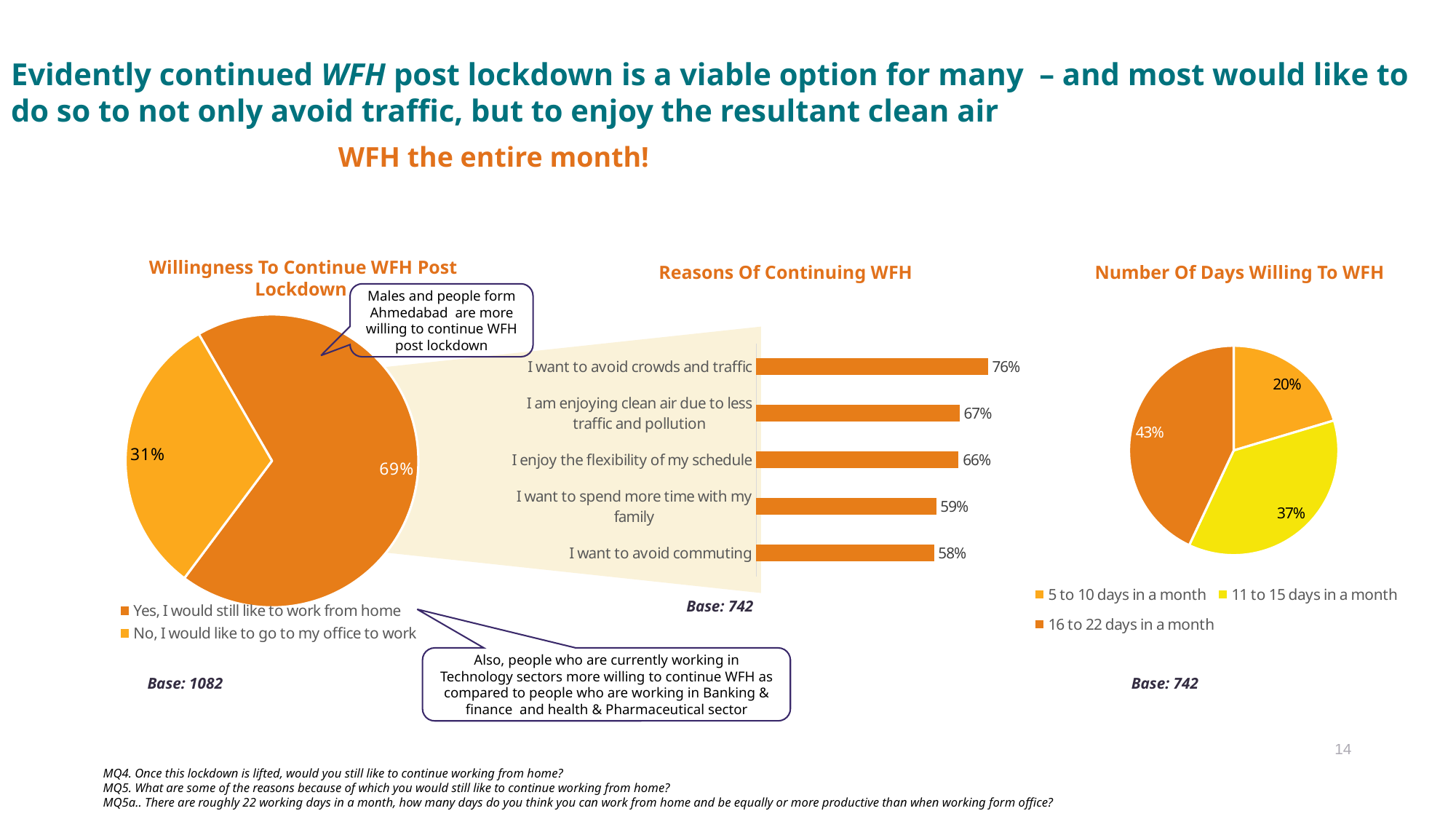
How many categories does the legend of the 'Number Of Days Willing To WFH' pie chart list? 3 In the 'Willingness To Continue WFH Post Lockdown' pie chart, what share of respondents said 'Yes, I would still like to work from home'? 69% In the 'Number Of Days Willing To WFH' pie chart, which category has the smallest share? 5 to 10 days in a month In the 'Number Of Days Willing To WFH' pie chart, what share corresponds to '16 to 22 days in a month'? 43% In the 'Reasons Of Continuing WFH' chart, which reason has the lowest value? I want to avoid commuting In the 'Reasons Of Continuing WFH' chart, which is larger: 'I am enjoying clean air due to less traffic and pollution' or 'I want to avoid commuting'? I am enjoying clean air due to less traffic and pollution What kind of chart is 'Reasons Of Continuing WFH'? Bar chart In the 'Reasons Of Continuing WFH' chart, what is the difference between 'I want to avoid crowds and traffic' and 'I want to spend more time with my family'? 17% How many reasons are listed in the 'Reasons Of Continuing WFH' chart? 5 In the 'Willingness To Continue WFH Post Lockdown' pie chart, what share of respondents said 'No, I would like to go to my office to work'? 31% In the 'Reasons Of Continuing WFH' chart, what is the value for 'I want to avoid crowds and traffic'? 76% In the 'Reasons Of Continuing WFH' chart, which reason has the highest value? I want to avoid crowds and traffic